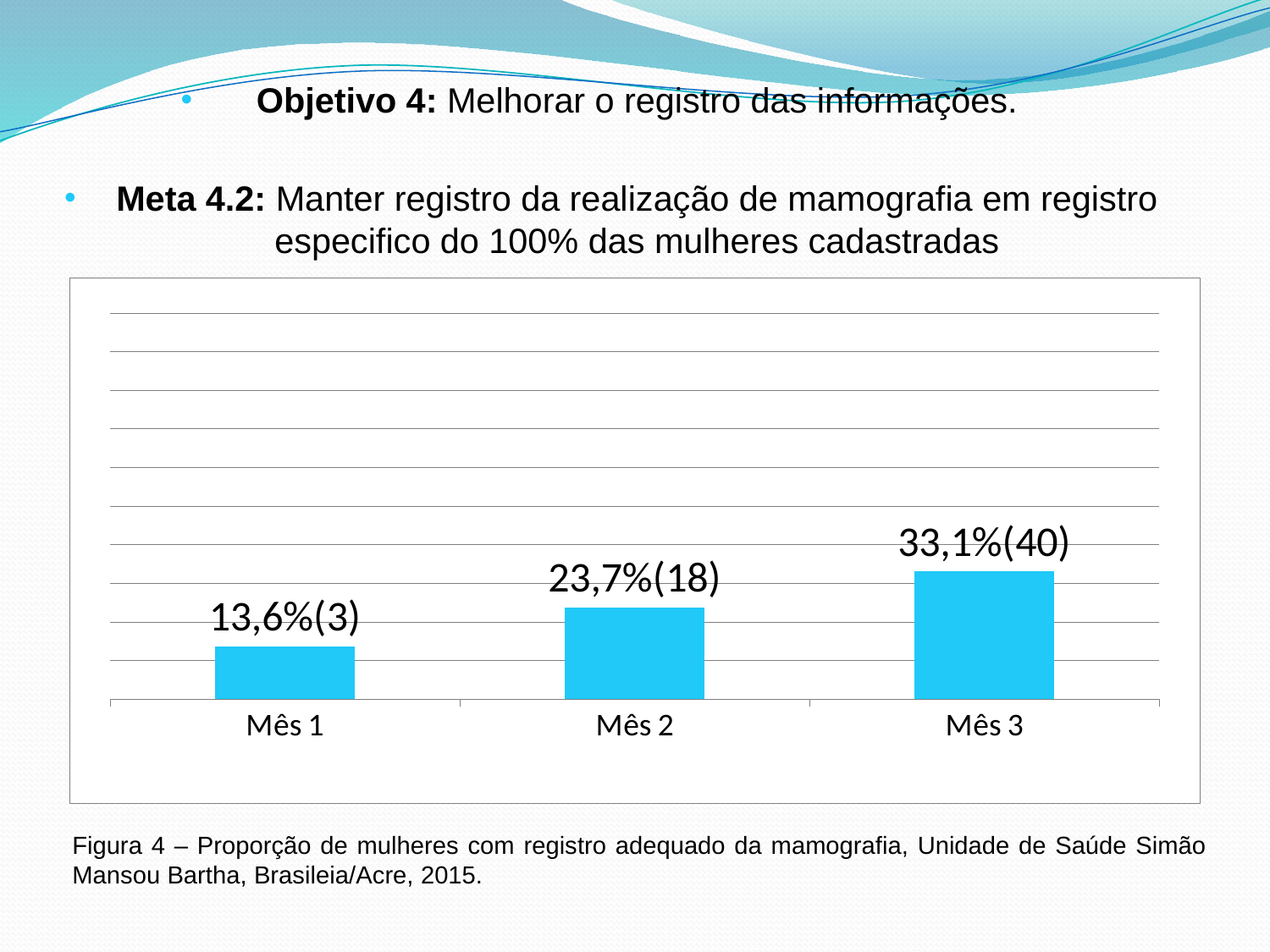
What is the difference in percentage between Mês 2 and Mês 1? 10,1% What is the figure number given in the caption below the chart? Figura 4 Which month has the lowest value? Mês 1 What kind of chart is shown on the slide? Bar chart What is the value shown for Mês 2? 23,7%(18) What percentage is shown for Mês 3? 33,1% Do the values rise or fall from Mês 1 to Mês 3? Rise How many months (categories) are shown on the chart? 3 What is the difference in percentage between Mês 3 and Mês 1? 19,5% What is the value shown for Mês 1? 13,6%(3) Which month has the highest value? Mês 3 Which is larger, the value for Mês 2 or the value for Mês 3? Mês 3